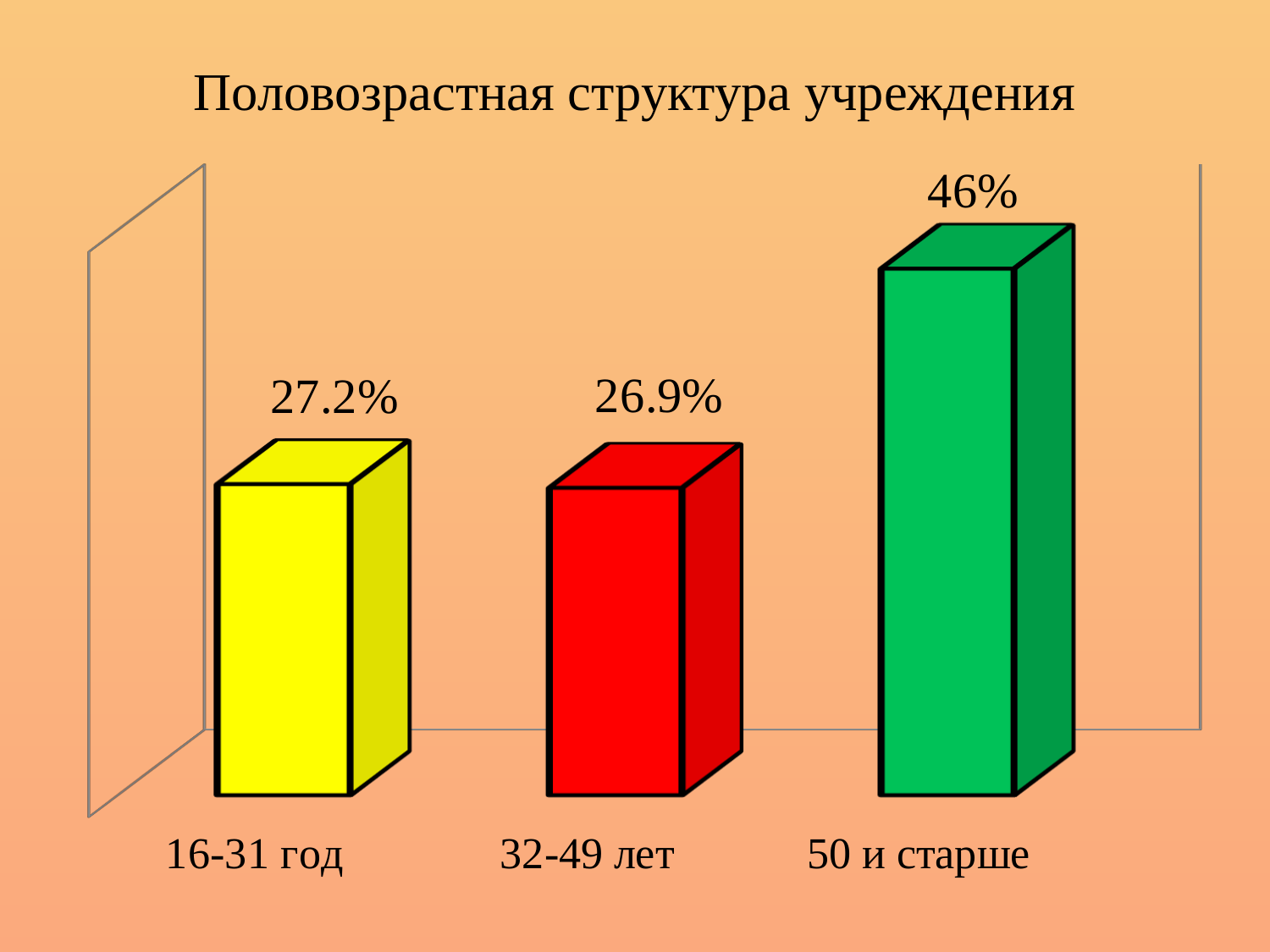
What is the value for the 32-49 лет category? 26.9% What kind of chart is shown on the slide? Bar chart What is the difference between the values for 16-31 год and 32-49 лет? 0.3% How many categories are shown in the chart? 3 What is the difference between the values for 50 и старше and 16-31 год? 18.8% What is the value for the 16-31 год category? 27.2% What is the title of the chart? Половозрастная структура учреждения Which category has the lowest value? 32-49 лет Which category has the highest value? 50 и старше What is the value for the 50 и старше category? 46% What colour is the bar for the 50 и старше category? Green Which is larger, the value for 50 и старше or the value for 32-49 лет? 50 и старше